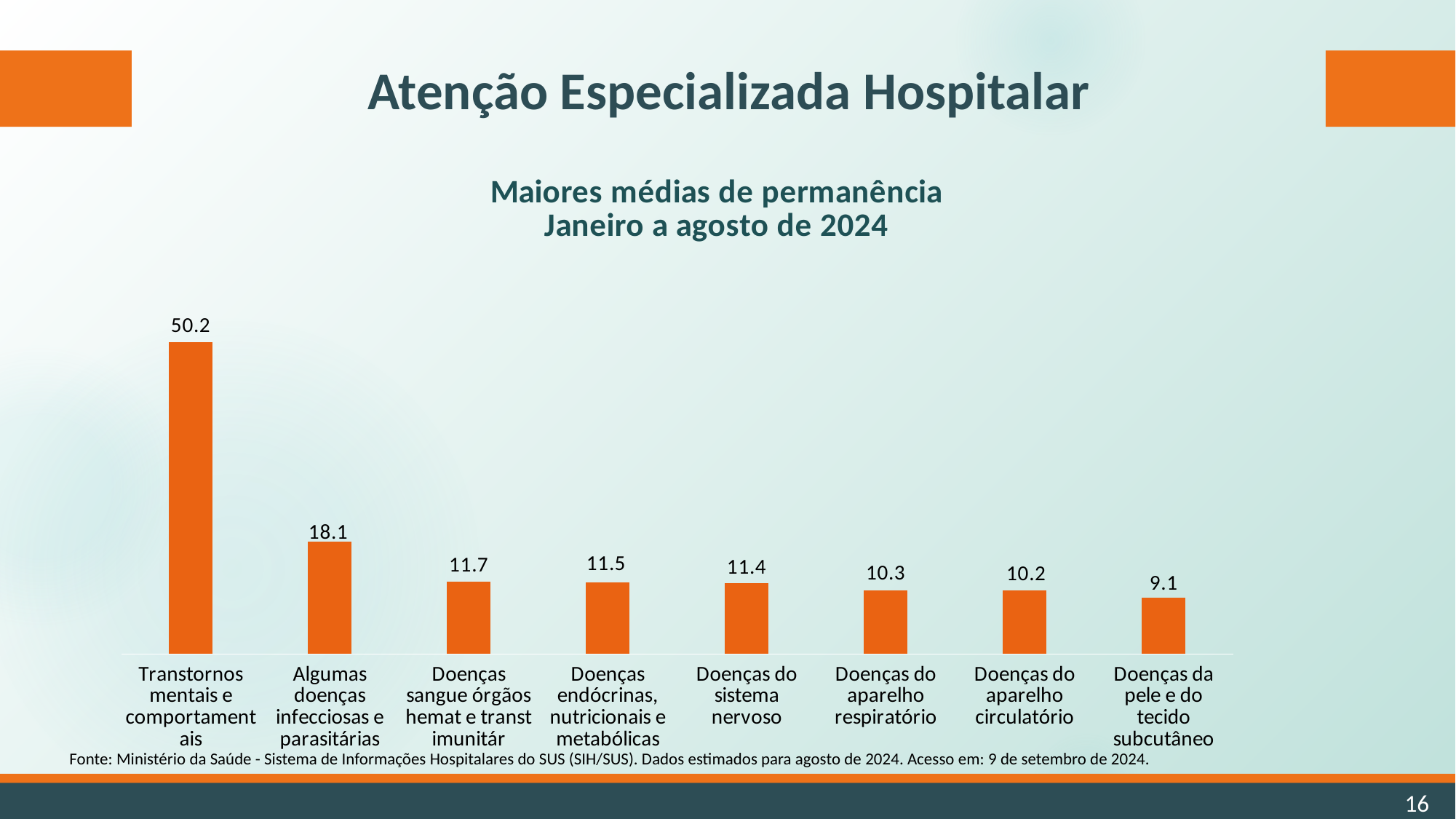
What is the value for Doenças do sistema nervoso? 11.4 What is the value for Transtornos mentais e comportamentais? 50.2 What is the difference between the values for Transtornos mentais e comportamentais and Algumas doenças infecciosas e parasitárias? 32.1 What is the title of the chart? Maiores médias de permanência Janeiro a agosto de 2024 How many categories are shown in the chart? 8 Which is larger, the value for Algumas doenças infecciosas e parasitárias or the value for Doenças sangue órgãos hemat e transt imunitár? Algumas doenças infecciosas e parasitárias Which category has the highest value? Transtornos mentais e comportamentais What kind of chart is shown on the slide? Bar chart What is the difference between the values for Doenças endócrinas, nutricionais e metabólicas and Doenças da pele e do tecido subcutâneo? 2.4 Do the values rise or fall from left to right along the x axis? Fall Which category has the lowest value? Doenças da pele e do tecido subcutâneo What is the value for Doenças do aparelho respiratório? 10.3